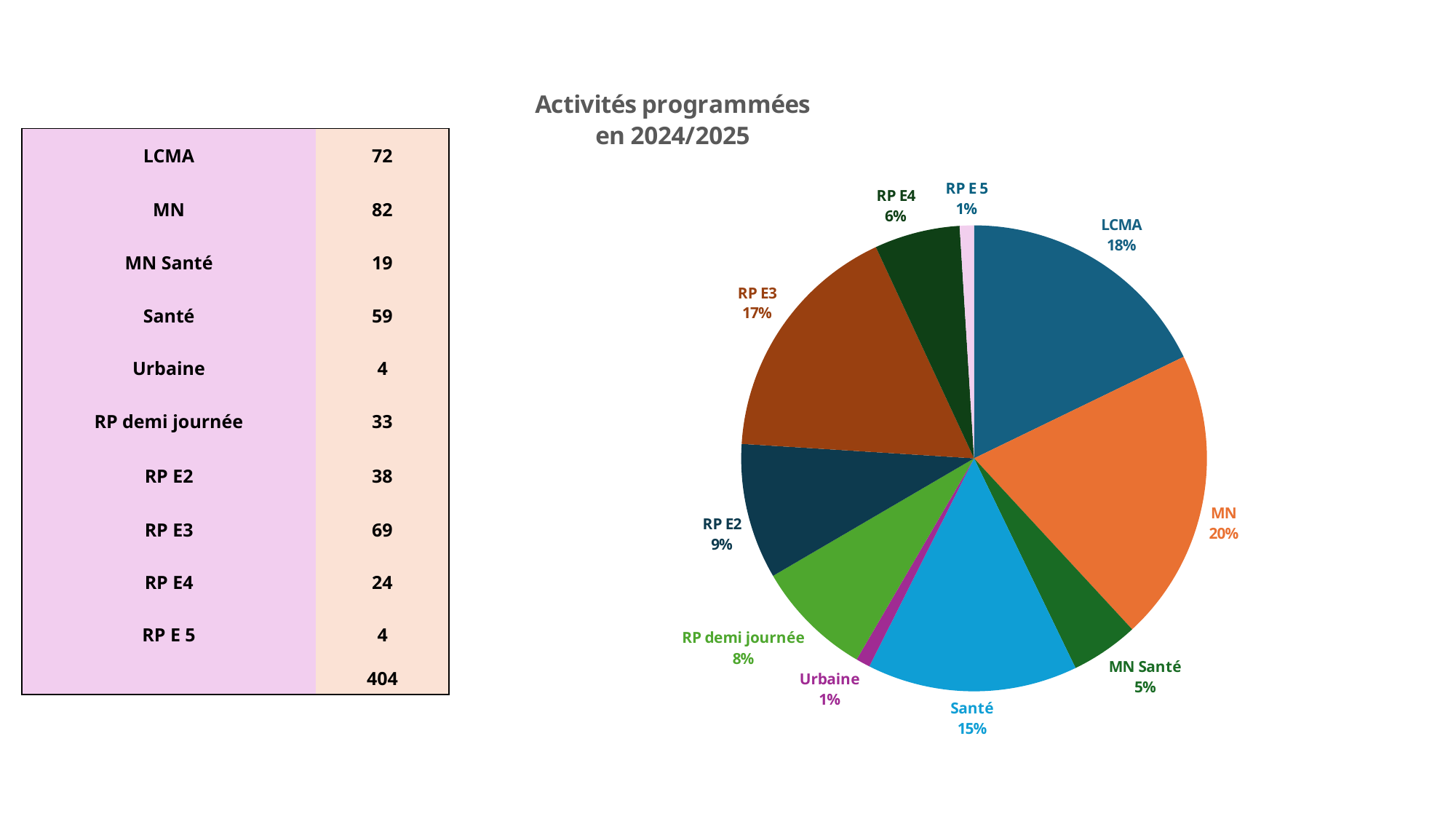
What share of the pie does Santé represent? 15% Which is larger, the share for RP E2 or the share for RP E4? RP E2 What is the difference in percentage points between the MN share and the MN Santé share? 15 What share of the pie does RP E4 represent? 6% How many slices does the pie chart have? 10 What is the title of the chart? Activités programmées en 2024/2025 What share of the pie does RP demi journée represent? 8% Which category has the largest slice of the pie? MN What kind of chart is shown on the slide? pie chart Which is larger, the share for LCMA or the share for Santé? LCMA